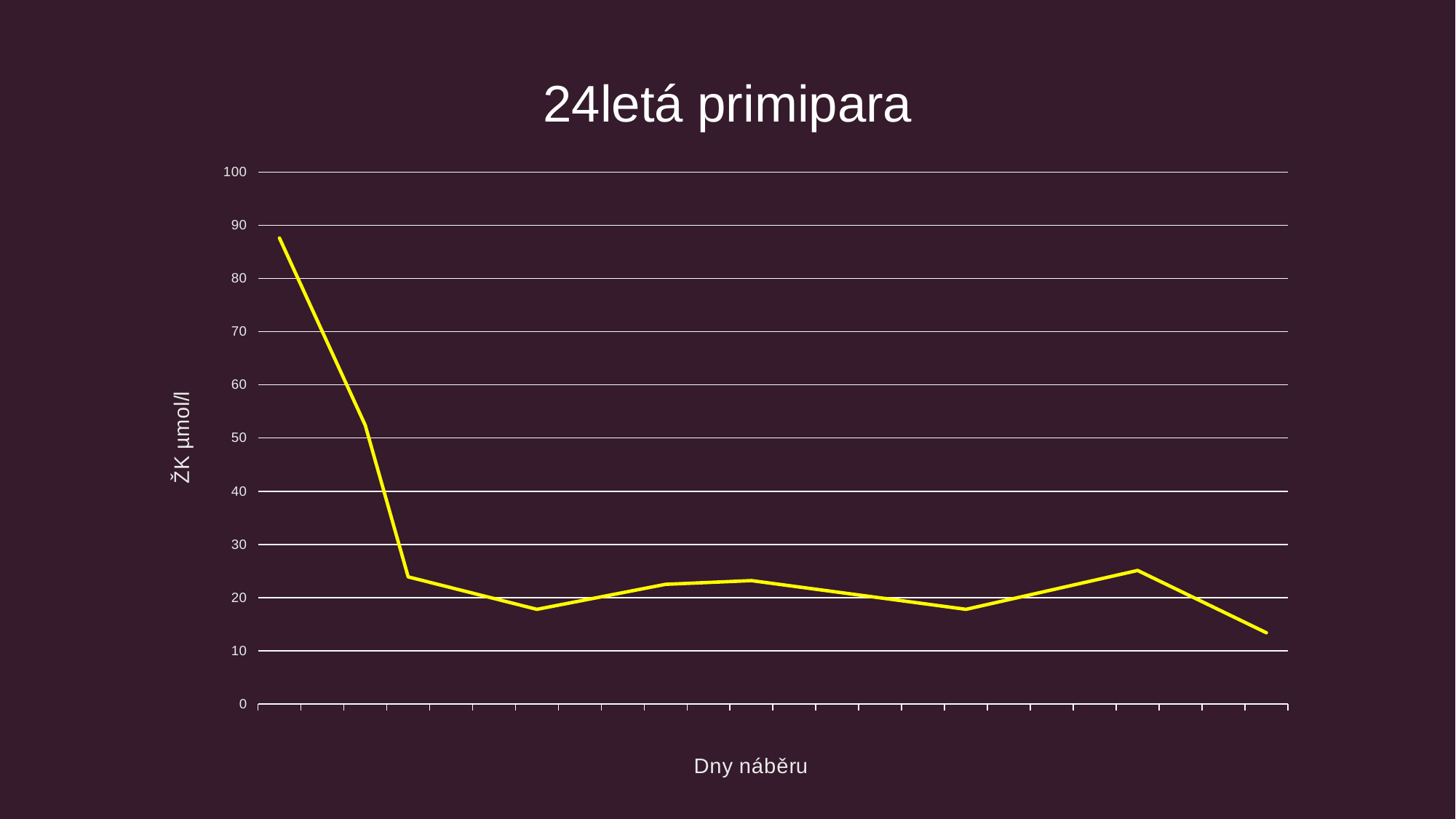
Is the value at the last point of the line greater or less than 20? less What is the label of the y axis? ŽK µmol/l What is the title of the chart? 24letá primipara Overall, do the values rise or fall along the x axis? fall Is the value at the first point of the line greater or less than 80? greater Is the value at the second point of the line greater or less than 50? greater What is the highest tick value shown on the y axis? 100 Is the highest point of the line at the start or at the end of the x axis? at the start What kind of chart is shown on the slide? line chart